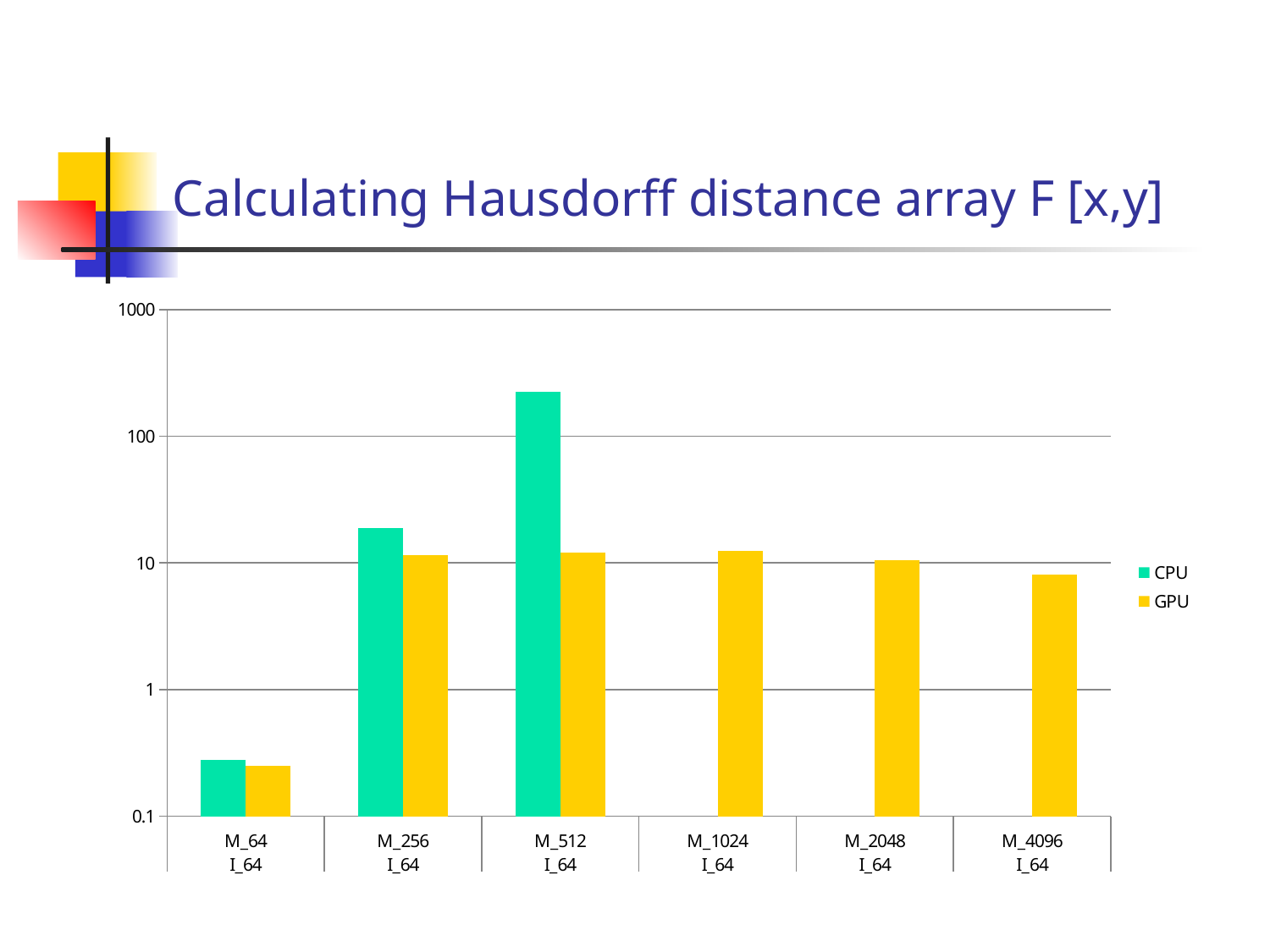
Is the GPU value for M_64 I_64 greater or less than 1? less How many series does the legend list? 2 For M_512 I_64, which is larger, the CPU value or the GPU value? CPU Is the CPU value for M_512 I_64 greater or less than 100? greater Is the GPU value for M_4096 I_64 greater or less than 10? less What is the title of the slide containing the chart? Calculating Hausdorff distance array F [x,y] Which category has the highest CPU value? M_512 I_64 How many categories are shown along the x axis? 6 What kind of chart is shown on the slide? bar chart For M_256 I_64, which is larger, the CPU value or the GPU value? CPU Which category has the lowest GPU value? M_64 I_64